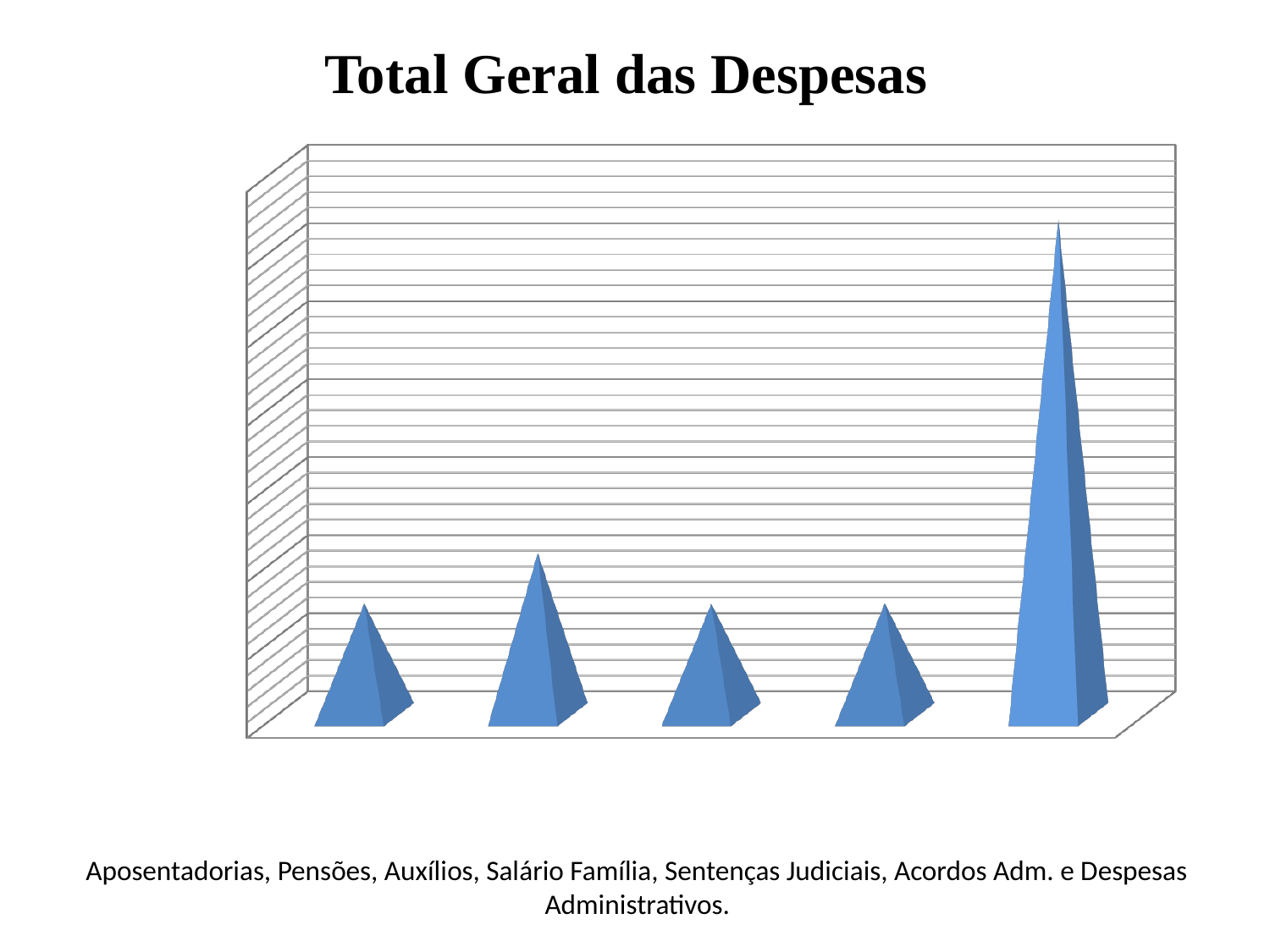
How many bars are plotted in the chart? 5 Which bar, by position from left, is the highest in the chart? the fifth (rightmost) bar Do the bar heights rise steadily from left to right across the chart? No Is the second bar from the left taller or shorter than the first bar? taller What is the title of the chart? Total Geral das Despesas Does the chart display a legend? No What kind of chart is shown on the slide? bar chart Is the second bar from the left taller or shorter than the third bar? taller Is the rightmost bar taller or shorter than the second bar from the left? taller